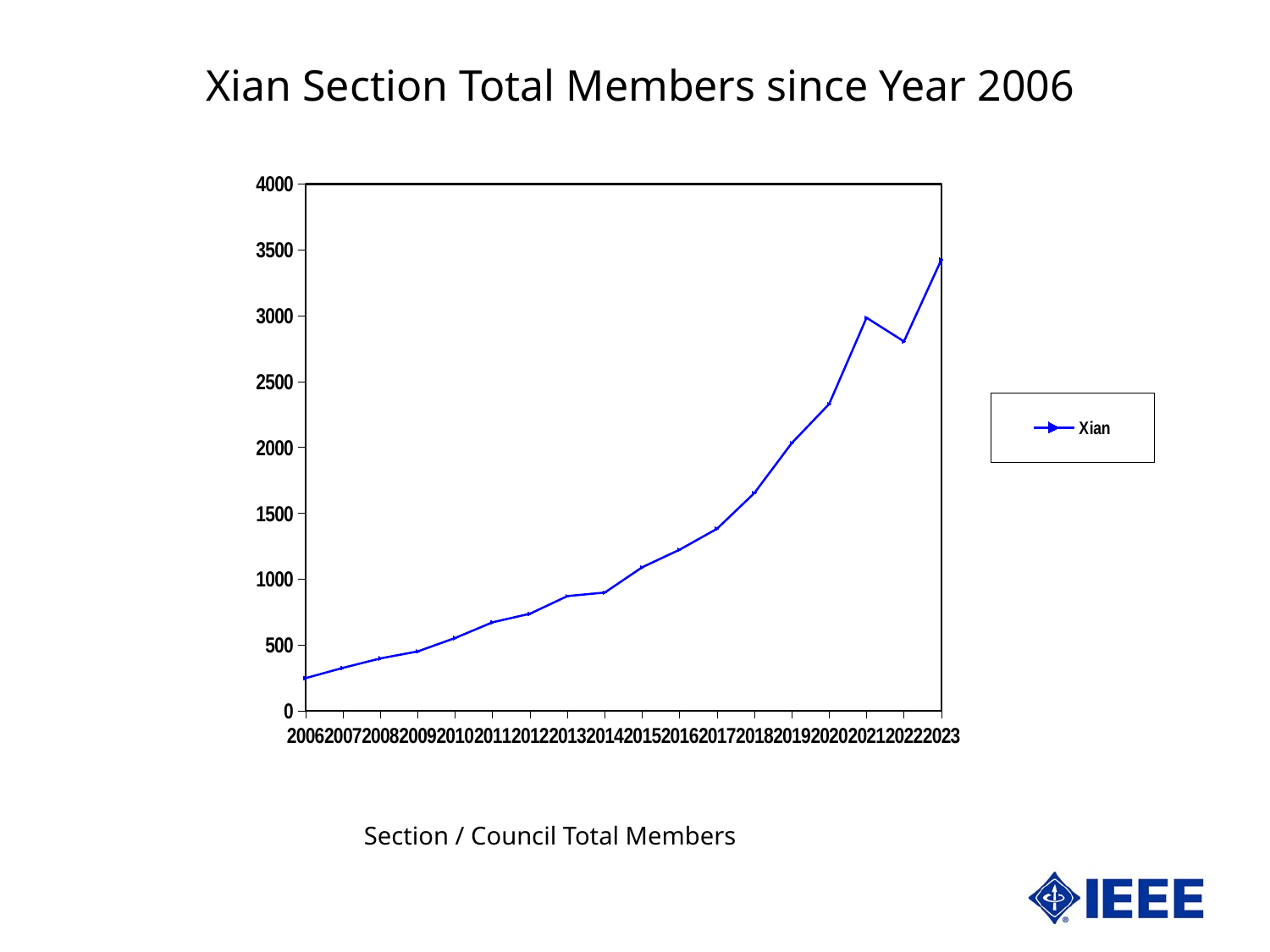
Do the values generally rise or fall from 2006 to 2023? rise Which year has the highest number of members? 2023 Is the value for 2023 greater or less than 3000? greater Which year has the larger value, 2021 or 2022? 2021 Is the value for 2018 greater or less than 1500? greater What is the name of the series shown in the legend? Xian Is the value for 2014 greater or less than 1000? less How many series does the legend list? 1 How many years are plotted along the x axis? 18 Which year has the lowest number of members? 2006 What kind of chart is shown on the slide? line chart